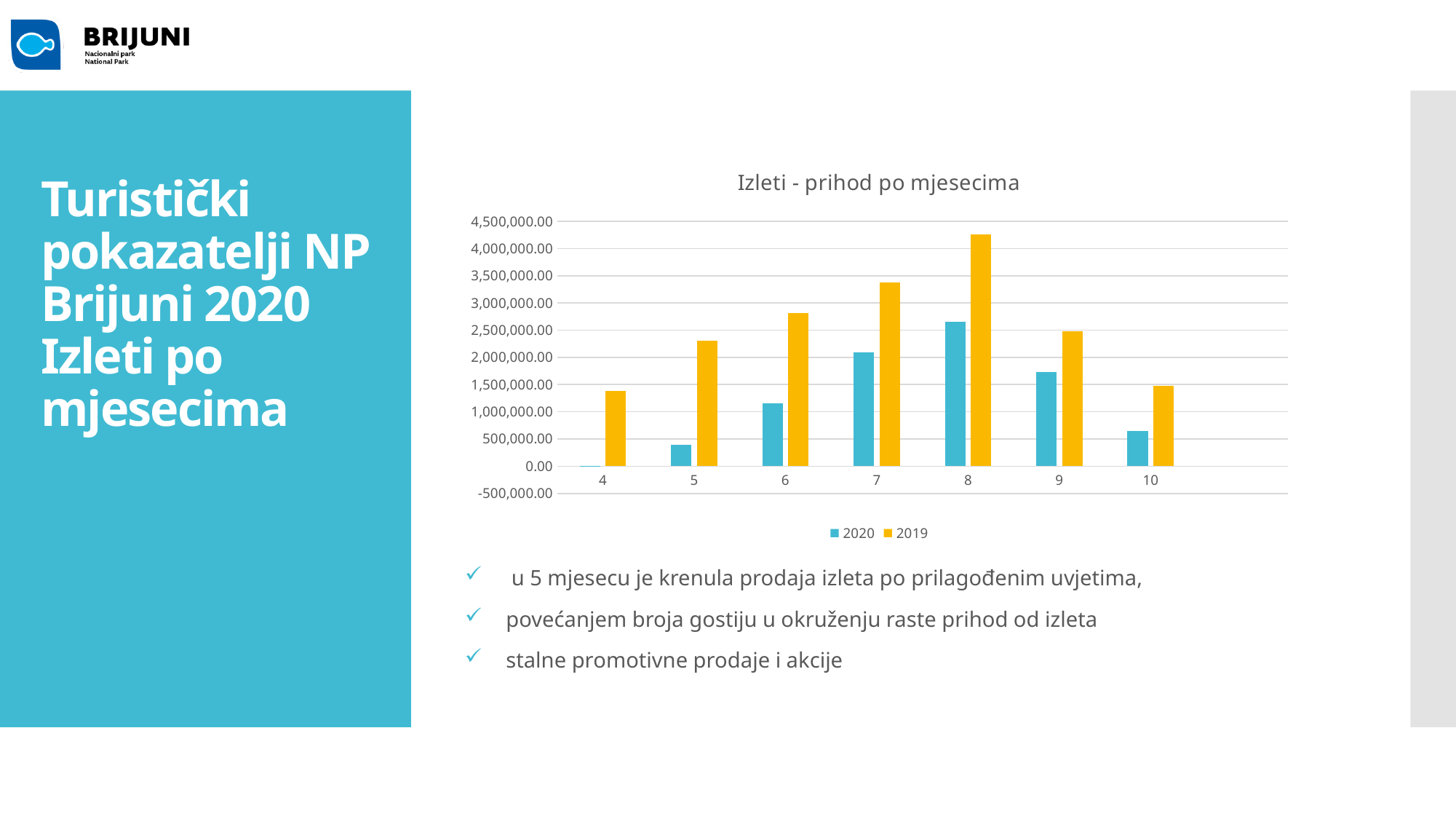
Is the 2019 value for month 8 greater or less than 4,000,000.00? greater In which month is the 2020 value lowest? 4 In which month is the 2019 value lowest? 4 In month 8, which series has the larger value, 2020 or 2019? 2019 How many months (categories) are shown on the x axis of the chart? 7 How many series does the chart legend list? 2 What kind of chart is shown on the slide? Bar chart What is the title of the chart? Izleti - prihod po mjesecima In which month is the 2019 value highest? 8 Is the 2020 value for month 5 greater or less than 500,000.00? less Which colour represents the 2019 series in the chart? Yellow In which month is the 2020 value highest? 8